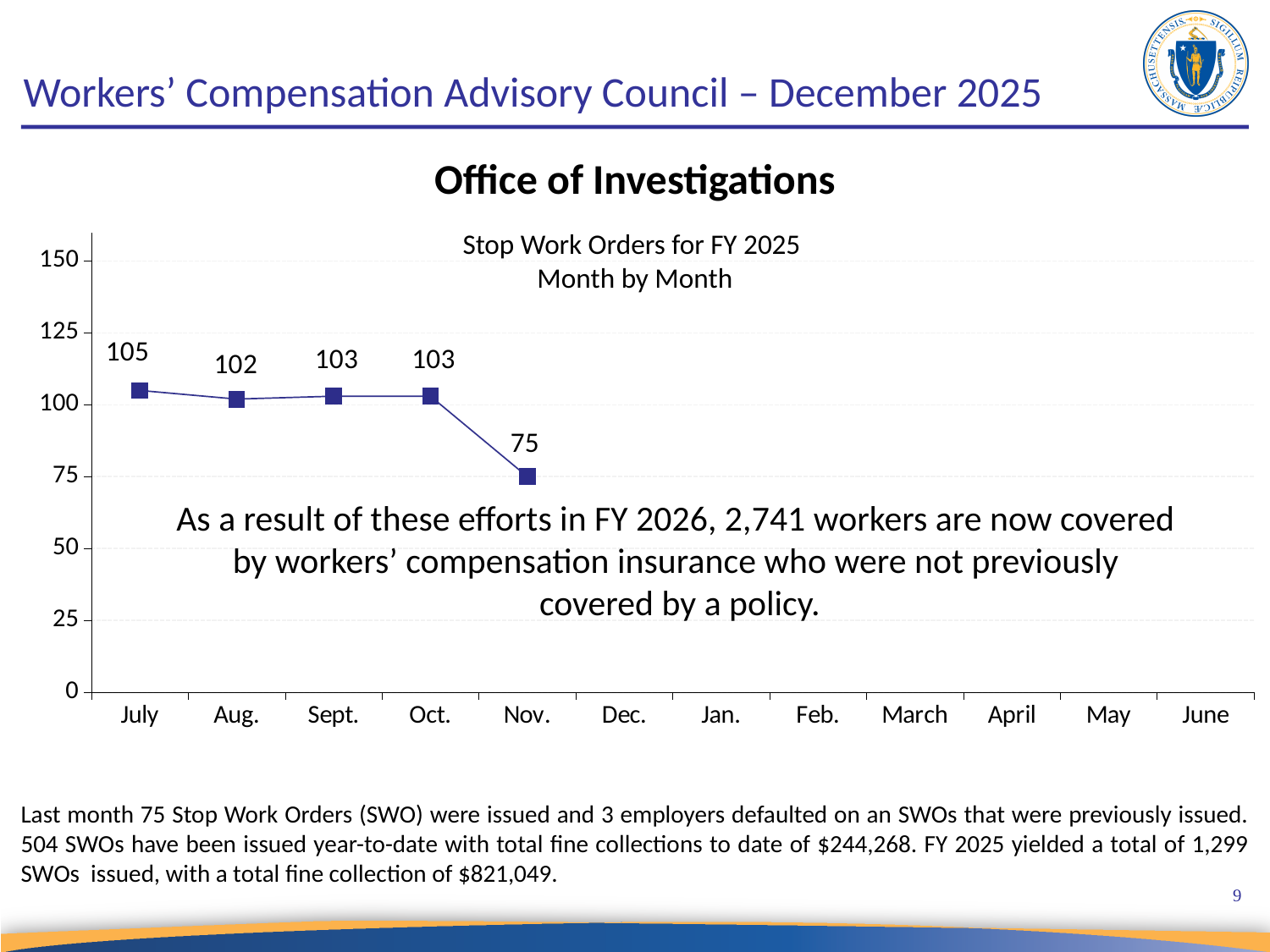
What is the value for Aug.? 102 How many months have a plotted data point? 5 Which month has the highest number of Stop Work Orders? July What is the value for Nov.? 75 What kind of chart is this? line chart What is the value for July? 105 Is the value for Nov. greater or less than 100? less How many month categories are shown on the x axis? 12 Which month has the lowest number of Stop Work Orders among those plotted? Nov. What is the title of the chart? Stop Work Orders for FY 2025 Month by Month What is the difference between the values for Oct. and Nov.? 28 Which is larger, the value for July or the value for Aug.? July